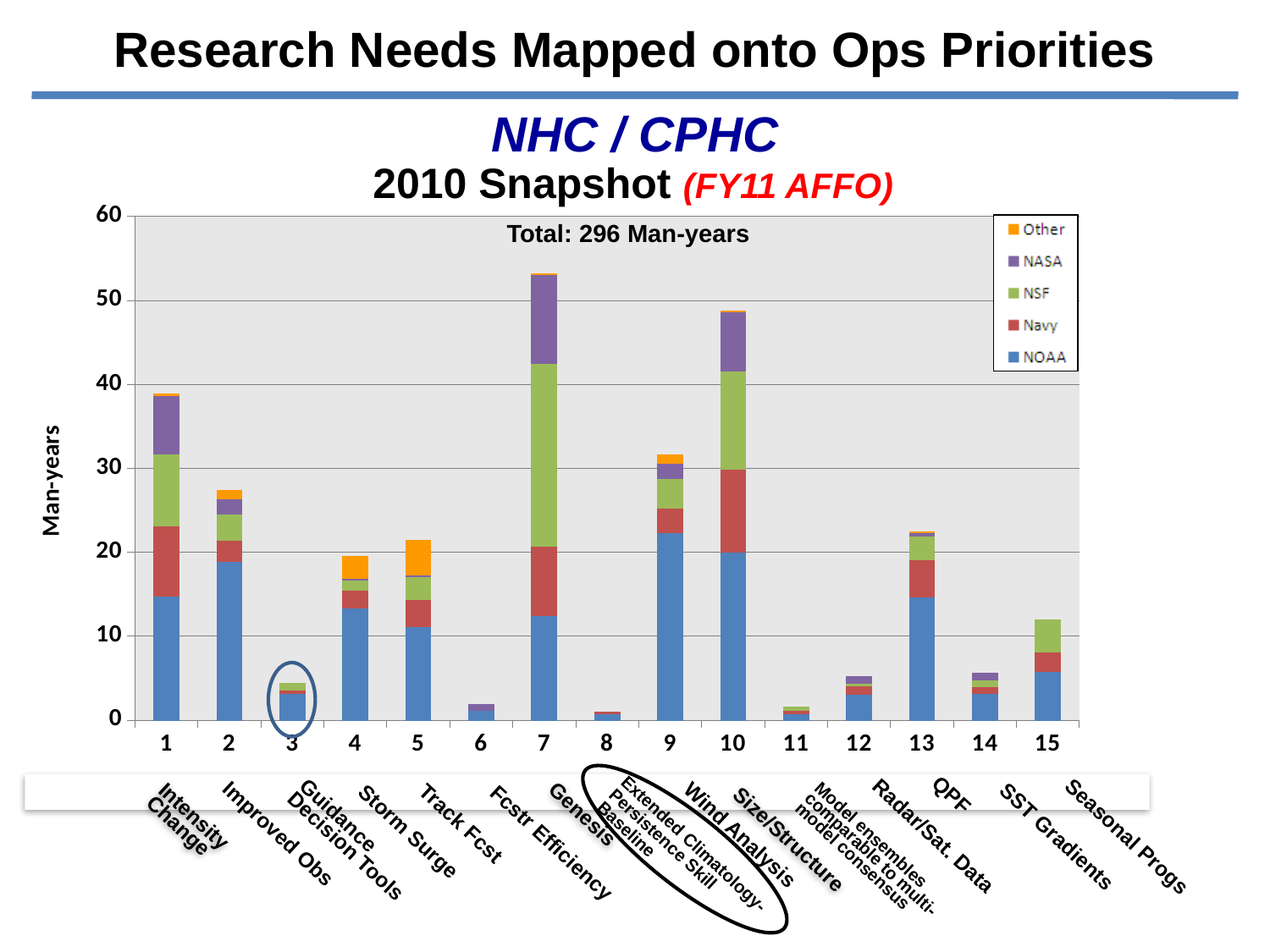
Which numbered category has the tallest stacked bar? 7 (Genesis) Is the total value for category 7 (Genesis) greater or less than 50? greater Which has the taller stacked bar, category 7 (Genesis) or category 10 (Size/Structure)? 7 (Genesis) What kind of chart is shown on the slide? Stacked bar chart What total in man-years is printed on the chart? Total: 296 Man-years Is the total value for category 6 (Fcstr Efficiency) greater or less than 10? less How many numbered categories are plotted along the x axis of the chart? 15 Is the total value for category 15 (Seasonal Progs) greater or less than 10? greater How many series does the chart's legend list? 5 Which numbered category has the shortest stacked bar? 8 (Extended Climatology-Persistence Skill Baseline) What is the label on the chart's y axis? Man-years